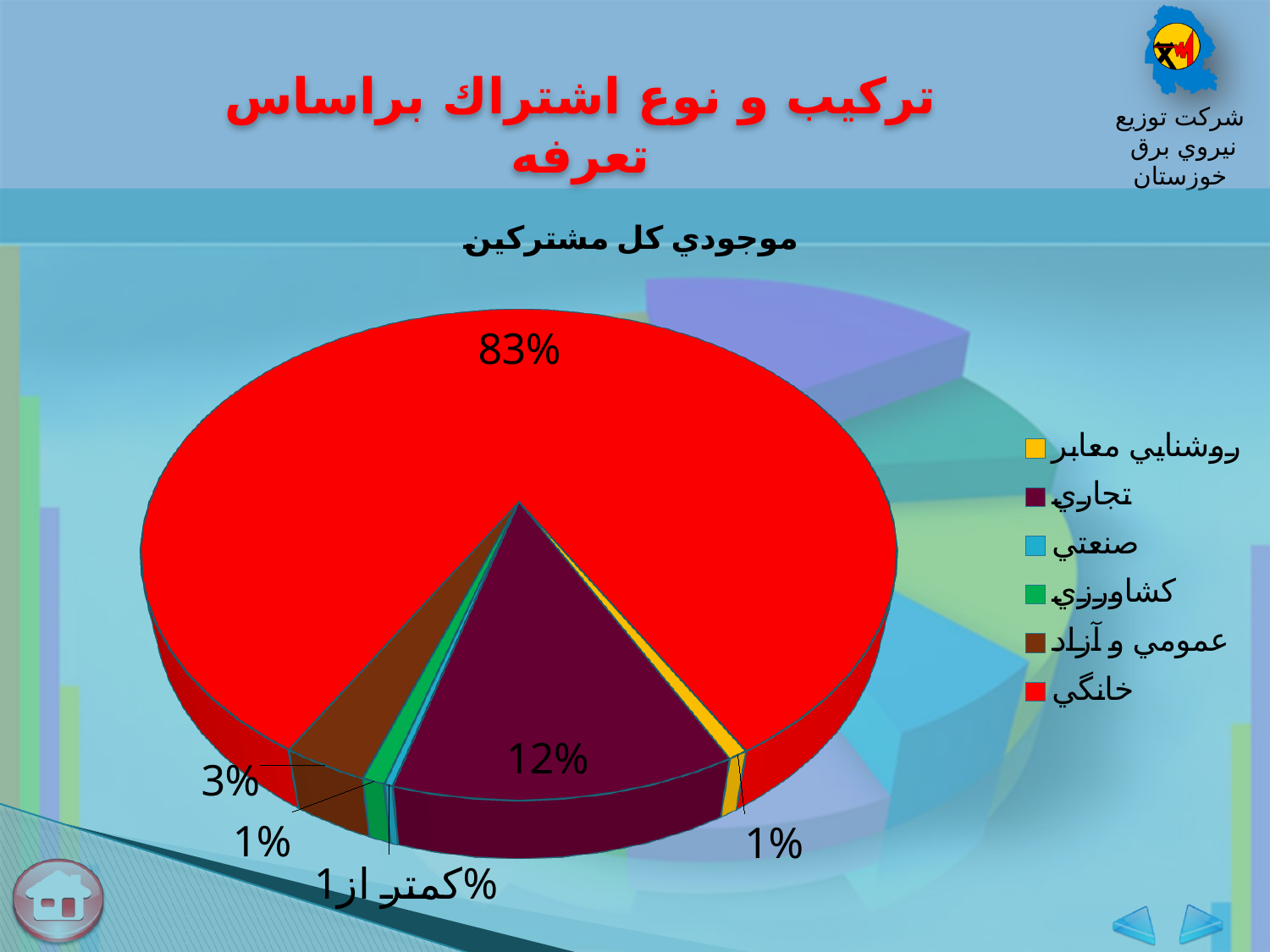
What colour represents خانگي in the chart? red How many categories does the legend list? 6 What percentage is shown for عمومي و آزاد? 3% What label is shown for the صنعتي slice? كمتر از 1% What percentage is shown for تجاري? 12% What is the difference in percentage points between خانگي and تجاري? 71 Which category has the smallest slice of the pie? صنعتي What is the title of the chart? موجودي كل مشتركين Which category has the largest slice of the pie? خانگي What kind of chart is shown on the slide? pie chart Which is larger, the slice for تجاري or the slice for عمومي و آزاد? تجاري What percentage is shown for خانگي? 83%